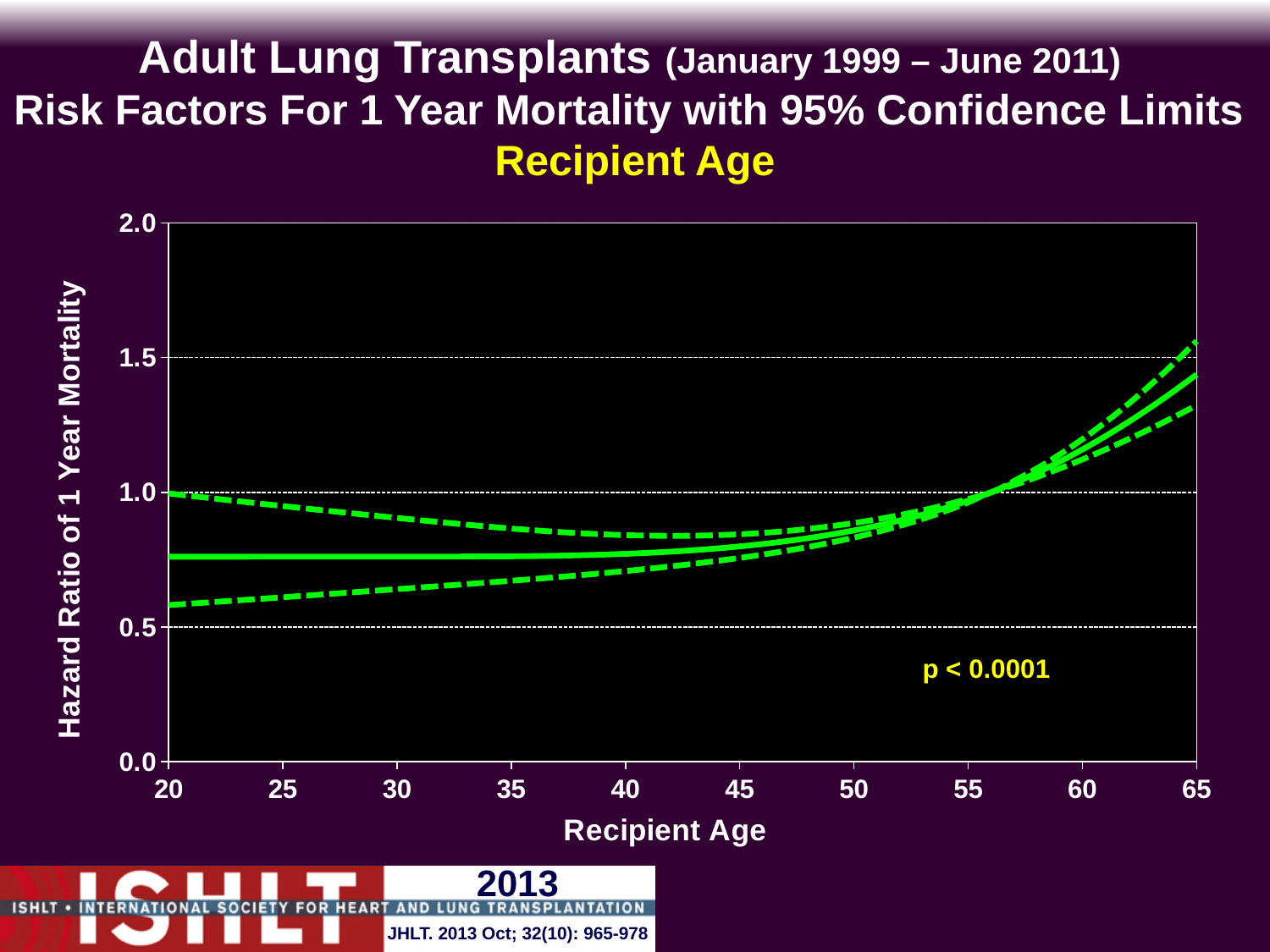
Is the hazard ratio of 1 year mortality (solid line) at recipient age 40 greater or less than 1.0? less How many lines are plotted on the chart? 3 Is the hazard ratio of 1 year mortality (solid line) at recipient age 20 greater or less than 1.0? less Is the hazard ratio of 1 year mortality (solid line) at recipient age 65 greater or less than 2.0? less What p-value is printed on the chart? p < 0.0001 Does the hazard ratio of 1 year mortality (solid line) rise or fall between recipient age 50 and recipient age 65? rise What is the range of recipient ages shown on the x axis? 20 to 65 Which recipient age has the larger hazard ratio of 1 year mortality on the solid line, 20 or 65? 65 What kind of chart is shown on the slide? line chart